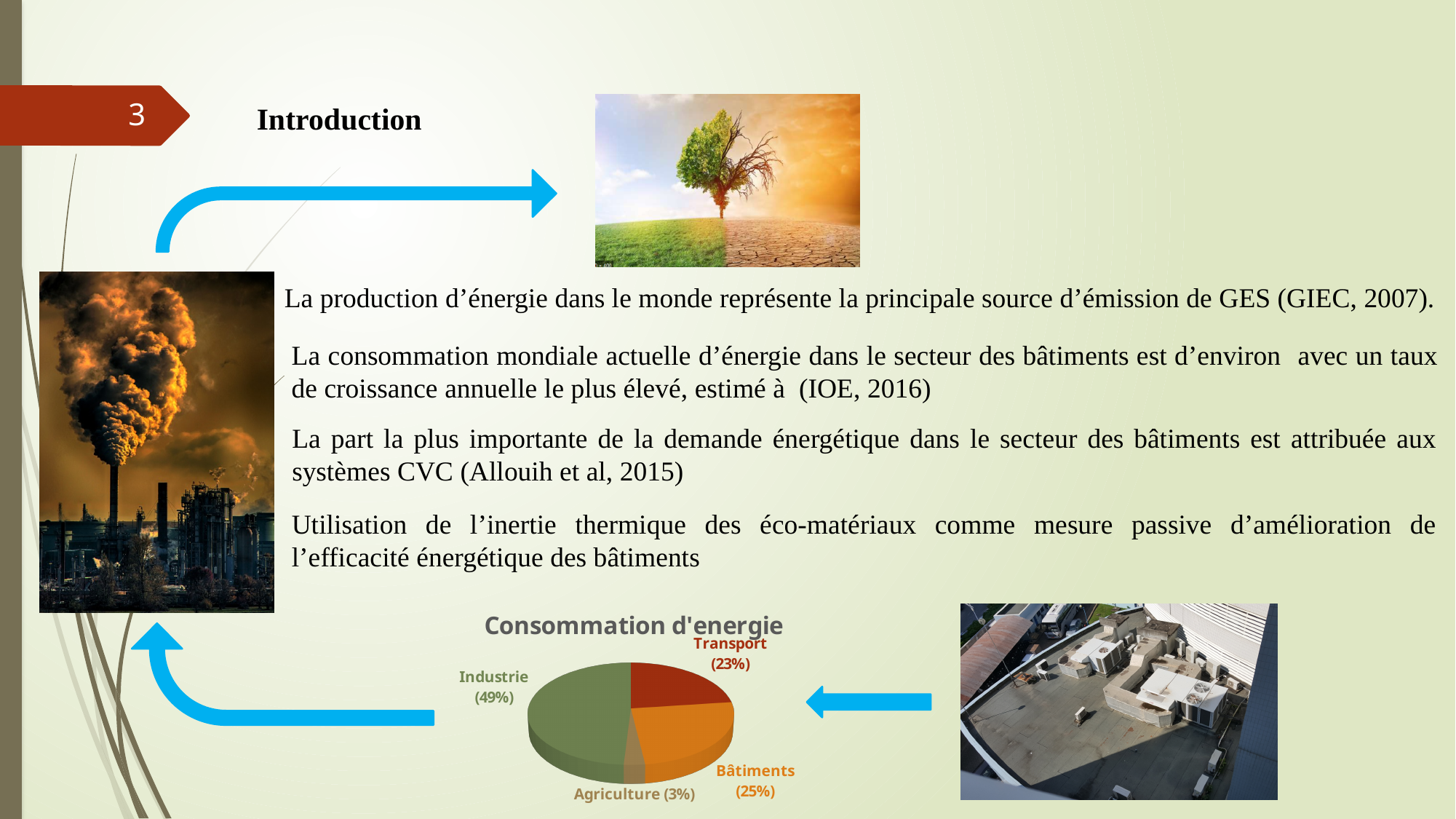
What share of the pie chart is Transport? 23% How many slices does the pie chart have? 4 Which is larger in the pie chart, Transport or Bâtiments? Bâtiments Which category has the smallest slice in the pie chart? Agriculture Which category has the largest slice in the pie chart? Industrie What is the title of the pie chart on the slide? Consommation d'energie What share of the pie chart is Bâtiments? 25% What is the difference in percentage points between Industrie and Bâtiments in the pie chart? 24 What type of chart is shown on the slide? pie chart What is the difference in percentage points between Transport and Agriculture in the pie chart? 20 What share of the pie chart is Industrie? 49%